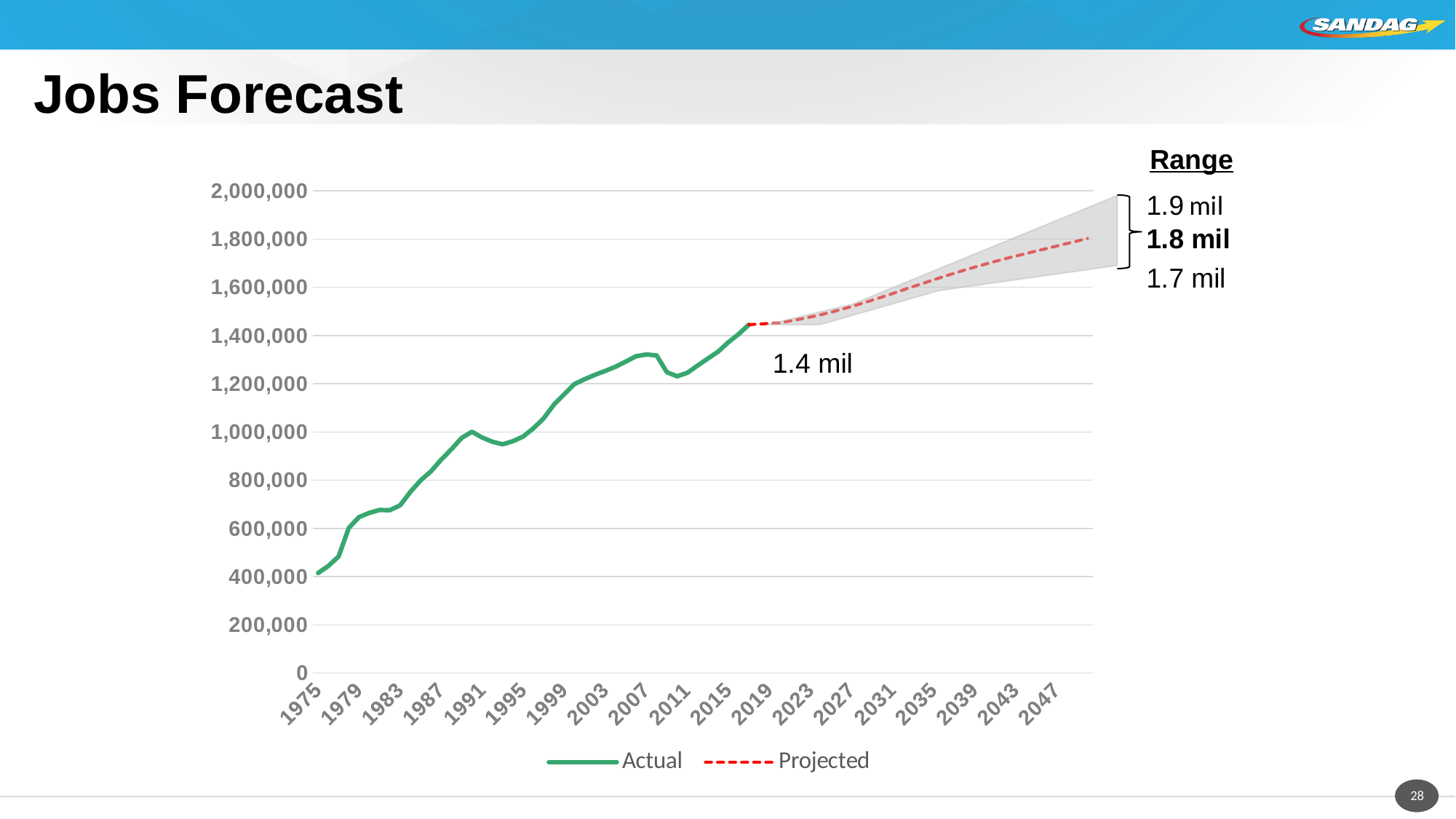
Do the Actual jobs values generally rise or fall from 1975 to 2019? rise What is the title of the chart? Jobs Forecast How many series does the legend list? 2 What is the low end of the forecast range shown at the right of the chart? 1.7 mil What kind of chart is shown on the slide? line chart Which year has the larger Actual value, 2007 or 2011? 2007 Is the Actual value for 2011 greater or less than 1,400,000? less What are the two series named in the legend? Actual and Projected What value is labelled on the chart where the Actual line ends and the Projected line begins, around 2019? 1.4 mil What is the projected jobs value at the end of the forecast, shown in bold in the Range annotation? 1.8 mil Is the Actual value for 1975 greater or less than 600,000? less What is the high end of the forecast range shown at the right of the chart? 1.9 mil